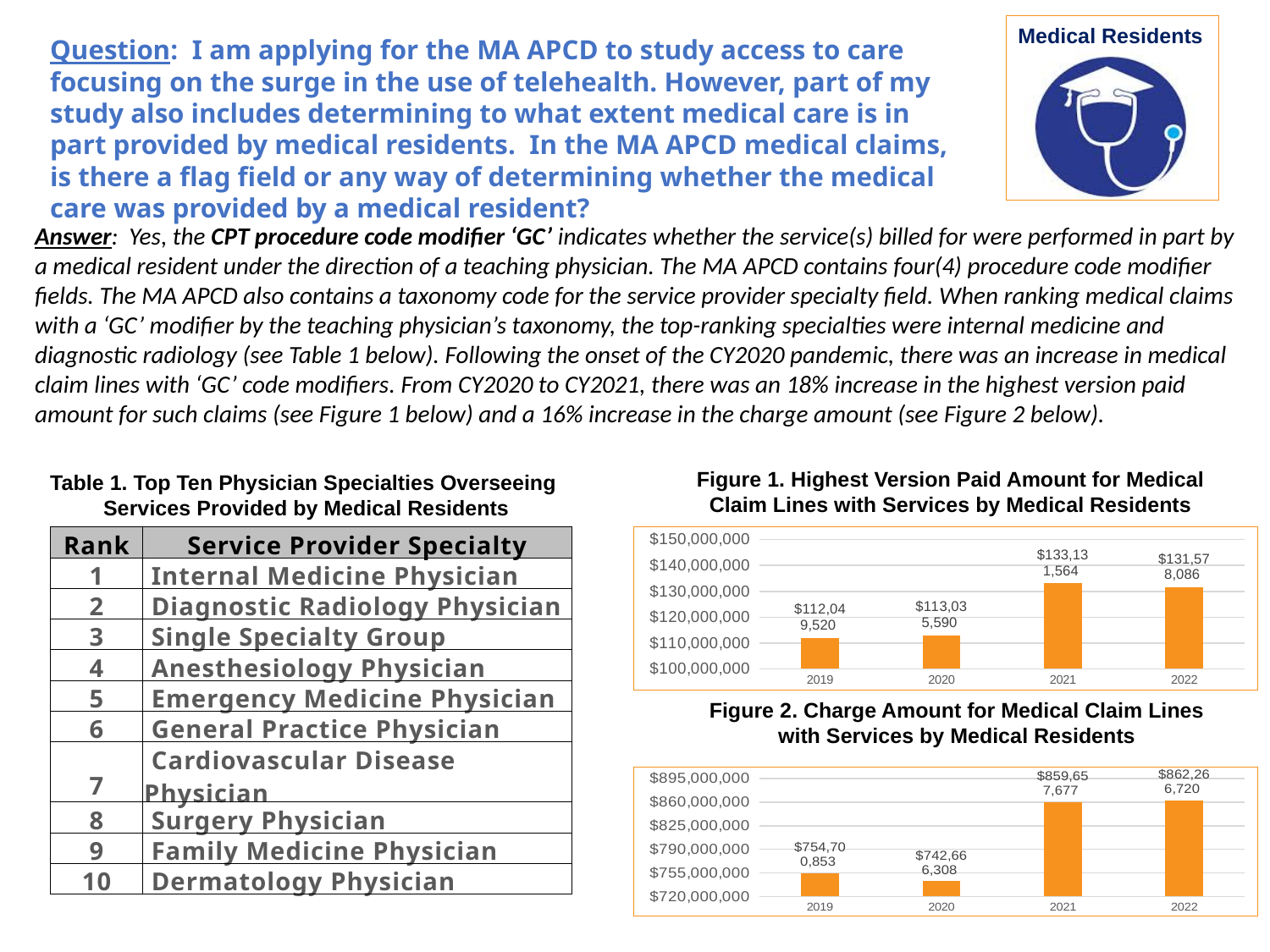
In Figure 1, is the paid amount for 2019 greater or less than $120,000,000? less In Figure 1, what is the highest version paid amount for 2019? $112,049,520 In Figure 2, what is the charge amount for 2022? $862,266,720 In Figure 1, what is the highest version paid amount for 2021? $133,131,564 In Figure 2, is the charge amount for 2021 greater or less than $825,000,000? greater In Figure 2, what is the difference between the charge amounts for 2021 and 2020? $116,991,369 In Figure 2, what is the charge amount for 2020? $742,666,308 In Figure 1, which year has the highest paid amount? 2021 How many years are plotted in Figure 2? 4 In Figure 1, what is the difference between the paid amounts for 2021 and 2020? $20,095,974 In Figure 2, which year has the lowest charge amount? 2020 In Figure 1, which year has the lowest paid amount? 2019